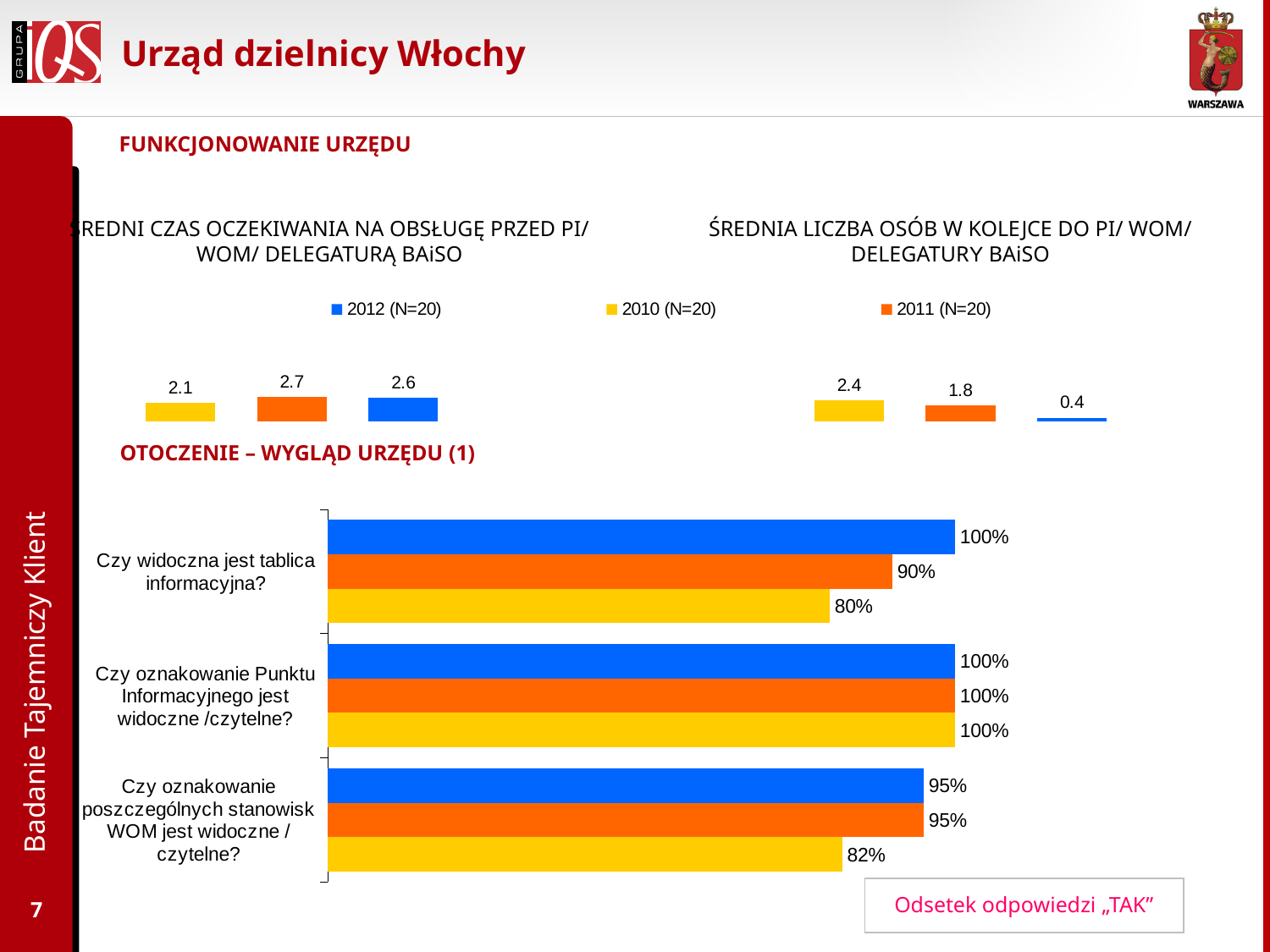
How many question categories are shown in the bottom chart 'Otoczenie – wygląd urzędu (1)'? 3 In the chart 'Średnia liczba osób w kolejce do PI/ WOM/ Delegatury BAiSO', what is the value for 2012 (N=20)? 0.4 In the bottom chart 'Otoczenie – wygląd urzędu (1)', what is the 2012 value for 'Czy oznakowanie poszczególnych stanowisk WOM jest widoczne / czytelne?'? 95% In the bottom chart 'Otoczenie – wygląd urzędu (1)', what is the 2010 value for 'Czy widoczna jest tablica informacyjna?'? 80% What type of chart is the bottom chart 'Otoczenie – wygląd urzędu (1)'? Bar chart In the chart 'Średnia liczba osób w kolejce do PI/ WOM/ Delegatury BAiSO', what is the difference between the 2010 and 2012 values? 2.0 In the chart 'Średni czas oczekiwania na obsługę przed PI/ WOM/ Delegaturą BAiSO', what is the value for 2011 (N=20)? 2.7 In the bottom chart 'Otoczenie – wygląd urzędu (1)', what is the difference between the 2012 and 2010 values for 'Czy widoczna jest tablica informacyjna?'? 20% In the chart 'Średni czas oczekiwania na obsługę przed PI/ WOM/ Delegaturą BAiSO', which year has the lowest value? 2010 (N=20) In the chart 'Średnia liczba osób w kolejce do PI/ WOM/ Delegatury BAiSO', which year has the highest value? 2010 (N=20) How many series does the legend above the top charts list? 3 In the chart 'Średni czas oczekiwania na obsługę przed PI/ WOM/ Delegaturą BAiSO', which is larger: the value for 2012 or the value for 2010? 2012